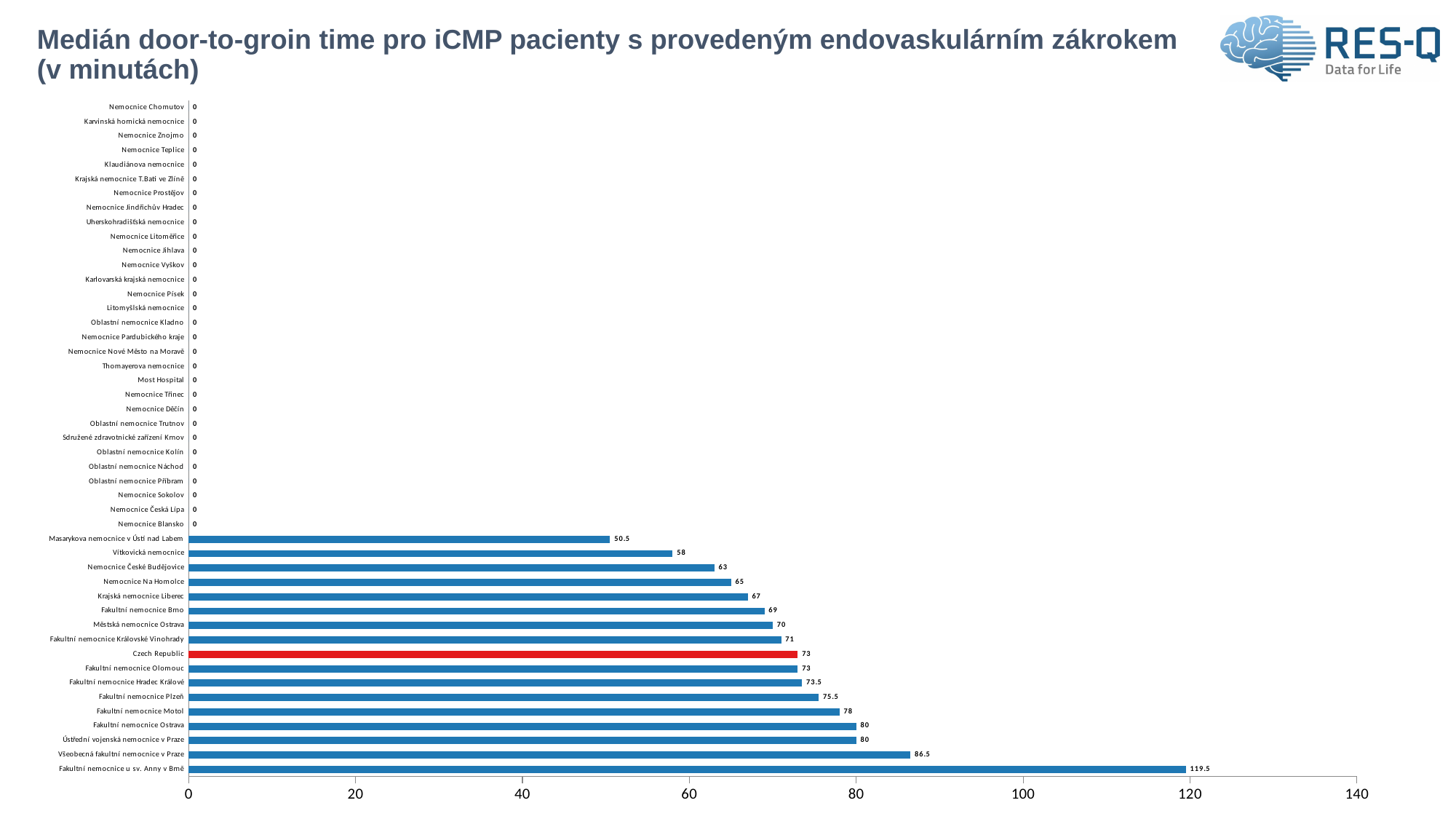
What is the difference between the values for Fakultní nemocnice u sv. Anny v Brně and Czech Republic? 46.5 What is the median door-to-groin time for Fakultní nemocnice u sv. Anny v Brně? 119.5 What value is shown for Czech Republic? 73 What is the difference between the values for Fakultní nemocnice Motol and Fakultní nemocnice Brno? 9 What is the value for Masarykova nemocnice v Ústí nad Labem? 50.5 Is the value for Vítkovická nemocnice greater or less than 60? less Among hospitals with a non-zero value, which has the lowest median door-to-groin time? Masarykova nemocnice v Ústí nad Labem How many hospitals have a non-zero value shown on the chart? 16 What kind of chart is shown on the slide? Bar chart Which is larger, the value for Fakultní nemocnice Plzeň or Nemocnice Na Homolce? Fakultní nemocnice Plzeň Which hospital has the highest median door-to-groin time? Fakultní nemocnice u sv. Anny v Brně What is the value for Všeobecná fakultní nemocnice v Praze? 86.5